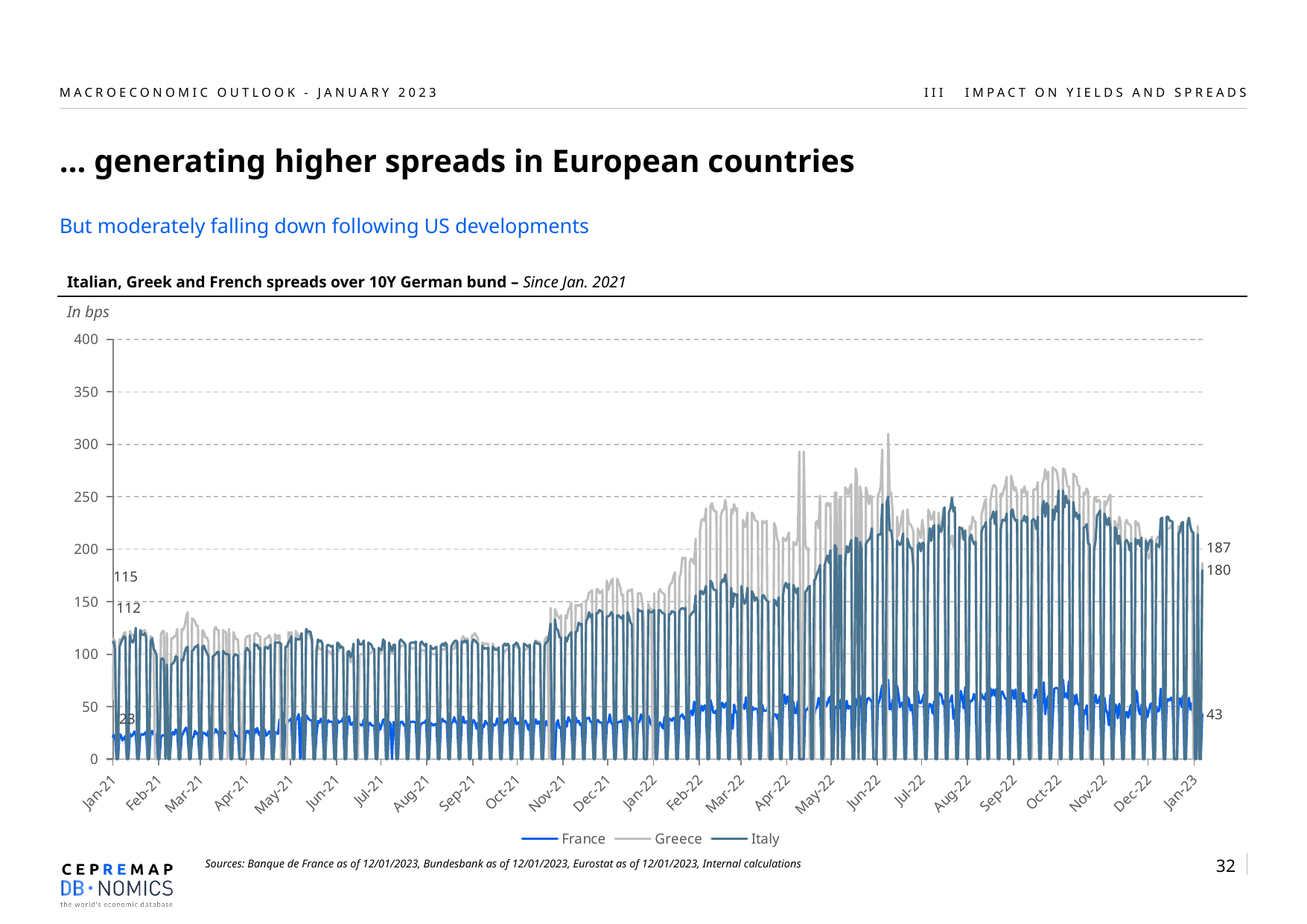
Is the peak value of the Greece series greater or less than 300? greater What unit is the y axis expressed in? bps What type of chart is shown on the slide? line chart At the end of the chart, which is larger: the France spread or the Italy spread? Italy Does the France spread rise or fall overall from Jan-21 to Jan-23? rise Which series are listed in the legend? France, Greece, Italy What is the labelled value of the France series at the end of the chart (Jan-23)? 43 By how much did the labelled France spread change between Jan-21 (23) and Jan-23 (43)? 20 Which series has the lowest values throughout the chart? France Which series reaches the highest peak on the chart? Greece What is the labelled value of the France series at the start of the chart (Jan-21)? 23 How many series does the legend list? 3